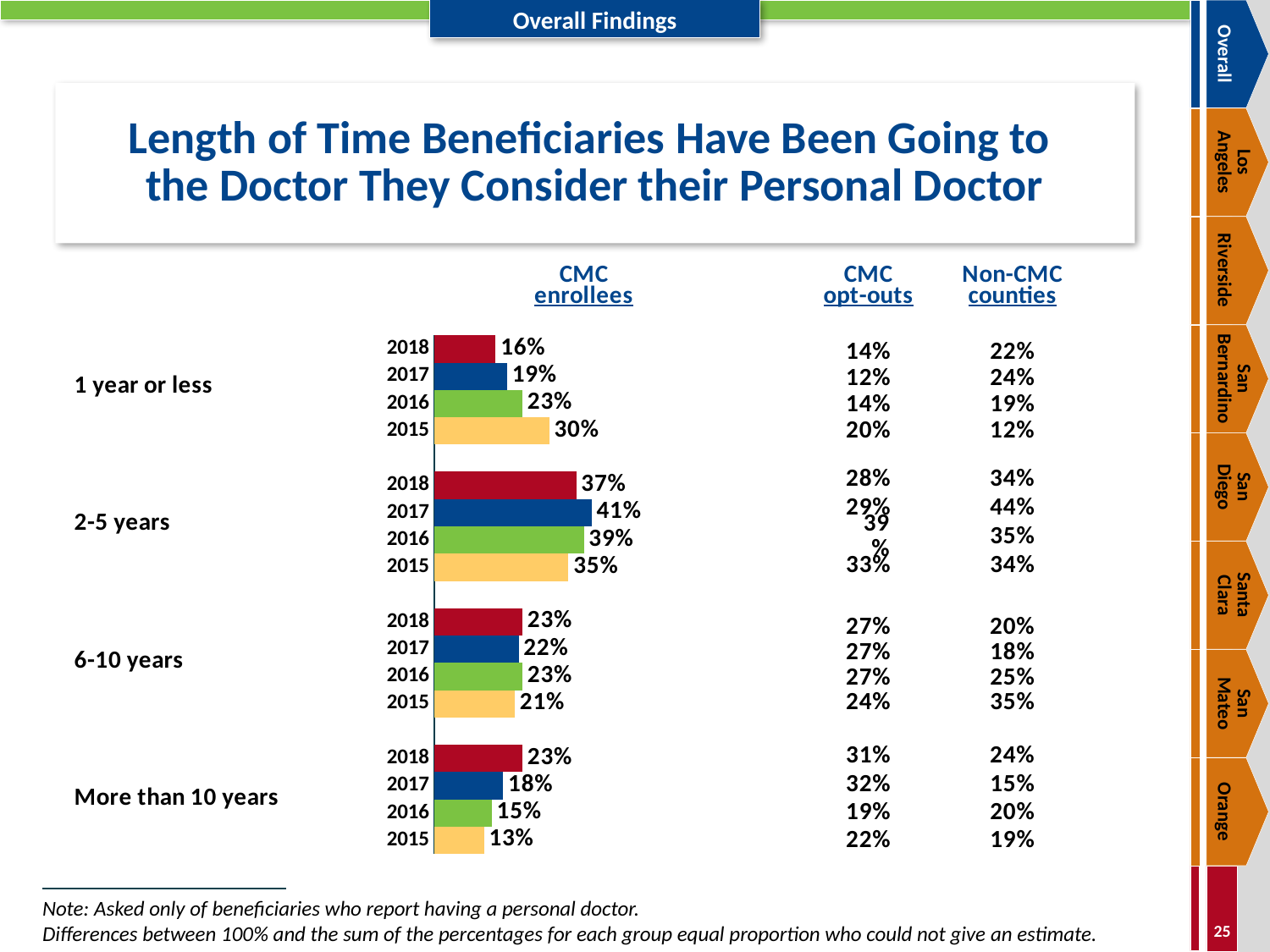
In the CMC enrollees bar chart, which year has the highest value in the 2-5 years category? 2017 What kind of chart is used to show the CMC enrollees data? Bar chart In the CMC enrollees bar chart, what is the 2017 value for the 2-5 years category? 41% In the CMC enrollees bar chart, what percentage of beneficiaries in 2018 had been going to their personal doctor for 1 year or less? 16% In the CMC enrollees bar chart, which year has the lowest value in the 1 year or less category? 2018 How many years are shown as bars within each length-of-time category in the CMC enrollees chart? 4 In the CMC enrollees bar chart, what is the 2015 value for the More than 10 years category? 13% In the CMC enrollees bar chart, does the value for the 1 year or less category rise or fall from 2015 to 2018? Falls In the CMC enrollees bar chart, what is the 2016 value for the 6-10 years category? 23% In the CMC enrollees bar chart, which is larger for the More than 10 years category: the 2018 value or the 2016 value? 2018 In the CMC enrollees bar chart, what is the difference between the 2015 and 2018 values for the 1 year or less category? 14 percentage points In the CMC enrollees bar chart, what colour are the 2018 bars? Red